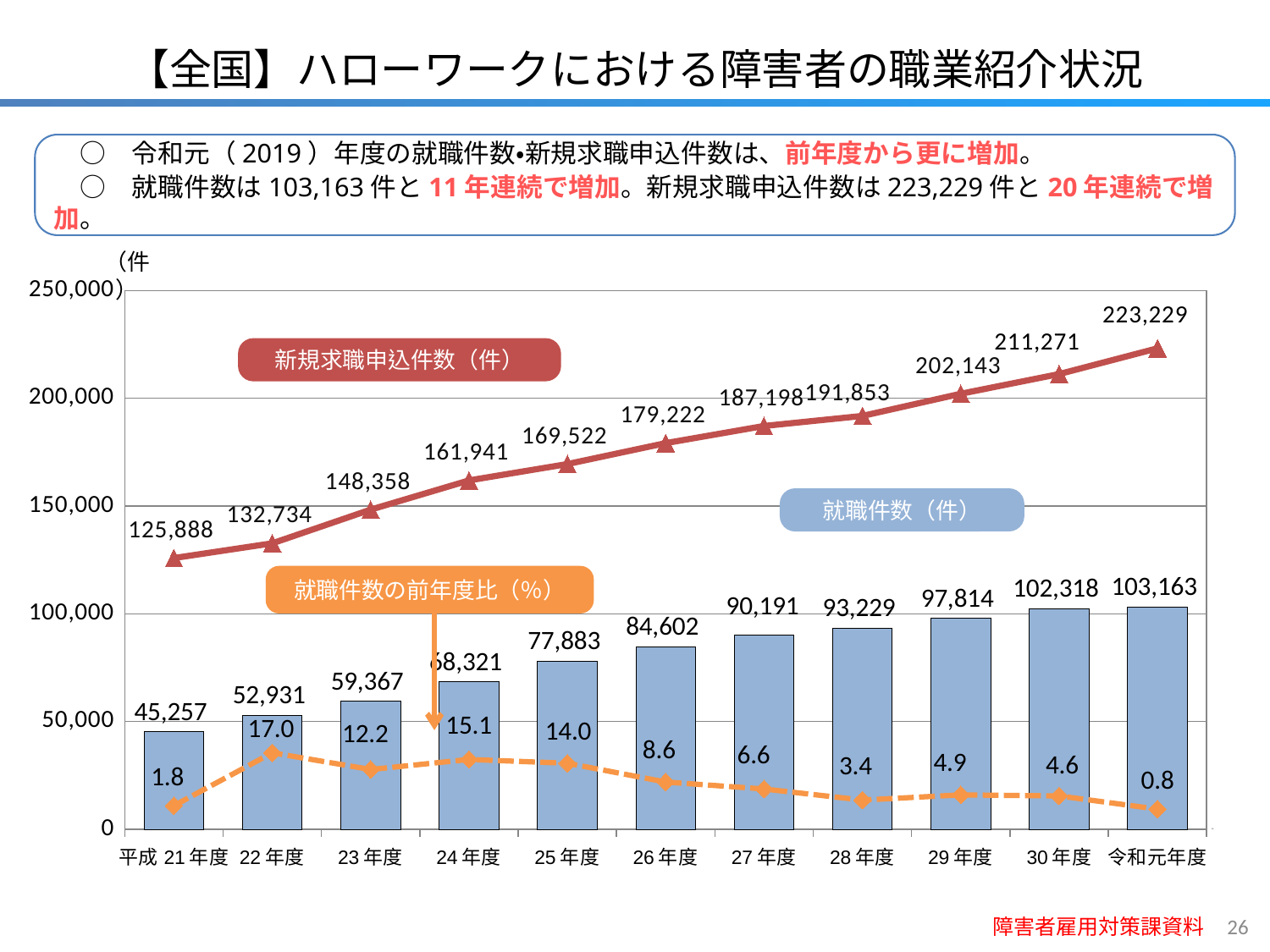
就職件数の前年度比（%）が最も高い年度はどれですか？ 22年度 平成26年度の就職件数の前年度比（%）はいくらですか？ 8.6 就職件数はどのような形式で表示されていますか？ 棒グラフ 新規求職申込件数は平成21年度から令和元年度にかけて増加していますか、減少していますか？ 増加 平成21年度と22年度では、どちらの就職件数が多いですか？ 22年度 令和元年度と30年度の新規求職申込件数の差はいくらですか？ 11,958 平成21年度の新規求職申込件数はいくらですか？ 125,888 令和元年度の就職件数はいくらですか？ 103,163 横軸には何年度分のデータが示されていますか？ 11 新規求職申込件数が最も多い年度はどれですか？ 令和元年度 平成29年度の就職件数は100,000より多いですか、少ないですか？ 少ない 就職件数の前年度比（%）が最も低い年度はどれですか？ 令和元年度